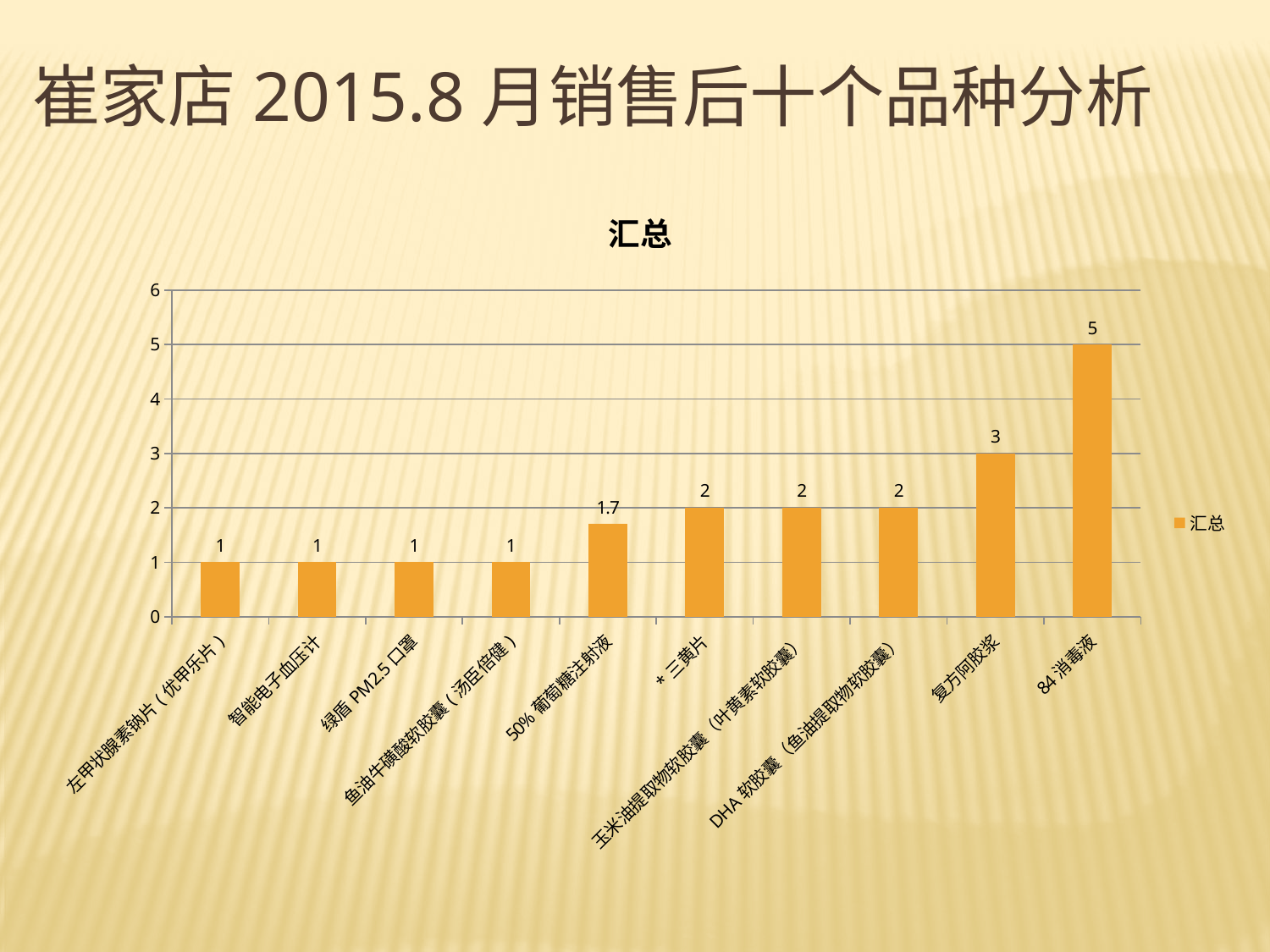
What is the title of the chart? 汇总 Which is larger, the value for 复方阿胶浆 or the value for DHA 软胶囊（鱼油提取物软胶囊）? 复方阿胶浆 Is the value for 84 消毒液 greater or less than 4? greater How many categories are shown on the x axis? 10 What is the value for 84 消毒液? 5 What is the difference between the values for 三黄片 and 50% 葡萄糖注射液? 0.3 What kind of chart is shown? bar chart What is the difference between the values for 84 消毒液 and 复方阿胶浆? 2 What is the value for 50% 葡萄糖注射液? 1.7 What is the value for 复方阿胶浆? 3 How many series does the legend list? 1 Which category has the highest value? 84 消毒液